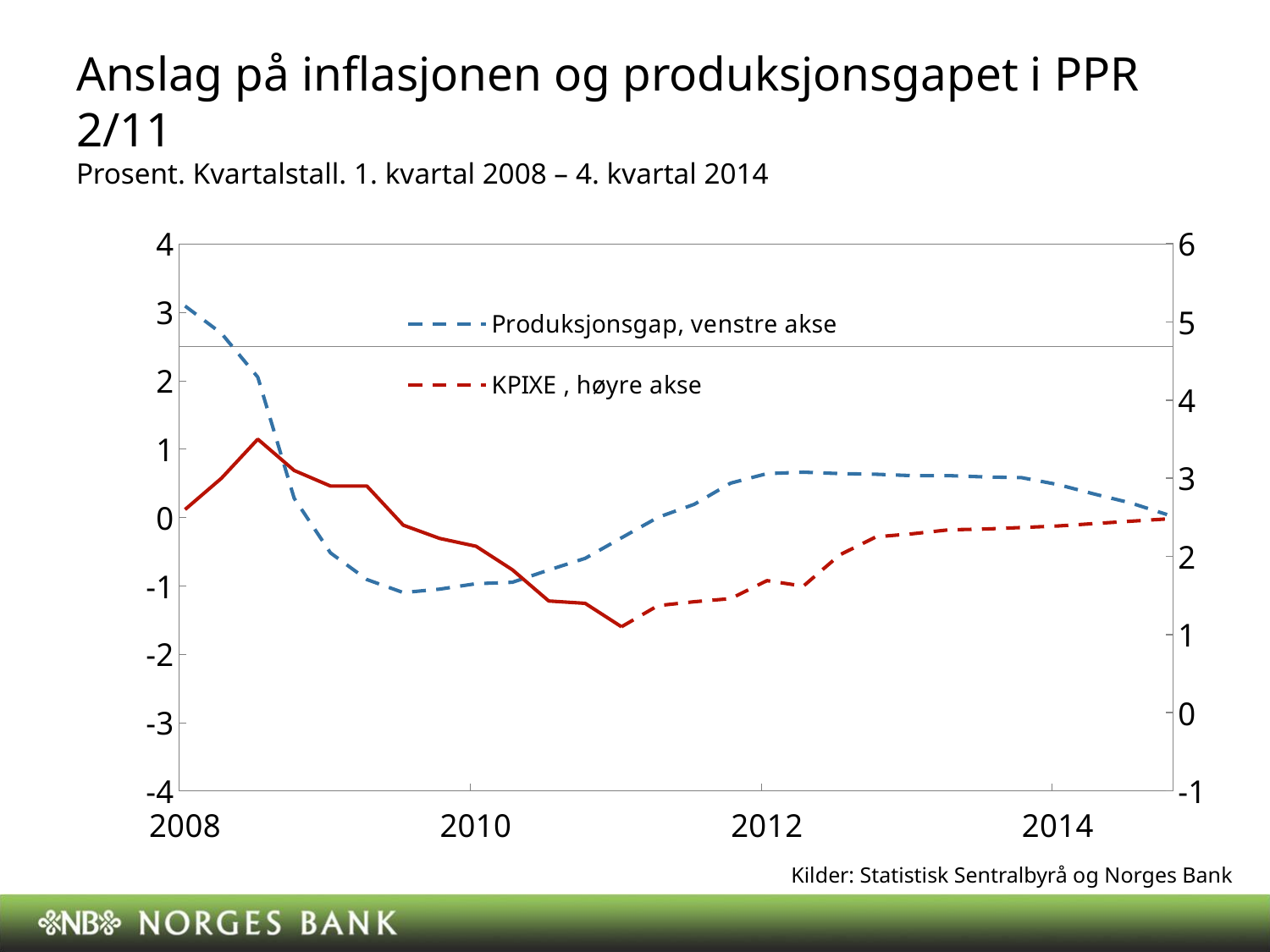
Around which year does the KPIXE series reach its lowest value? 2011 Is the lowest value of KPIXE, reached around 2011, greater or less than 2 on the right axis? less Does the Produksjonsgap series rise or fall between the start of 2008 and the start of 2010? fall Is the peak value of KPIXE in 2008 greater or less than 3 on the right axis? greater Is the value of Produksjonsgap at the start of 2010 greater or less than 0 on the left axis? less How many series does the legend list? 2 Which series is plotted against the right axis (høyre akse)? KPIXE What is the title of the chart? Anslag på inflasjonen og produksjonsgapet i PPR 2/11 What kind of chart is shown on the slide? Line chart Does the KPIXE series rise or fall between the start of 2012 and the end of 2014? rise